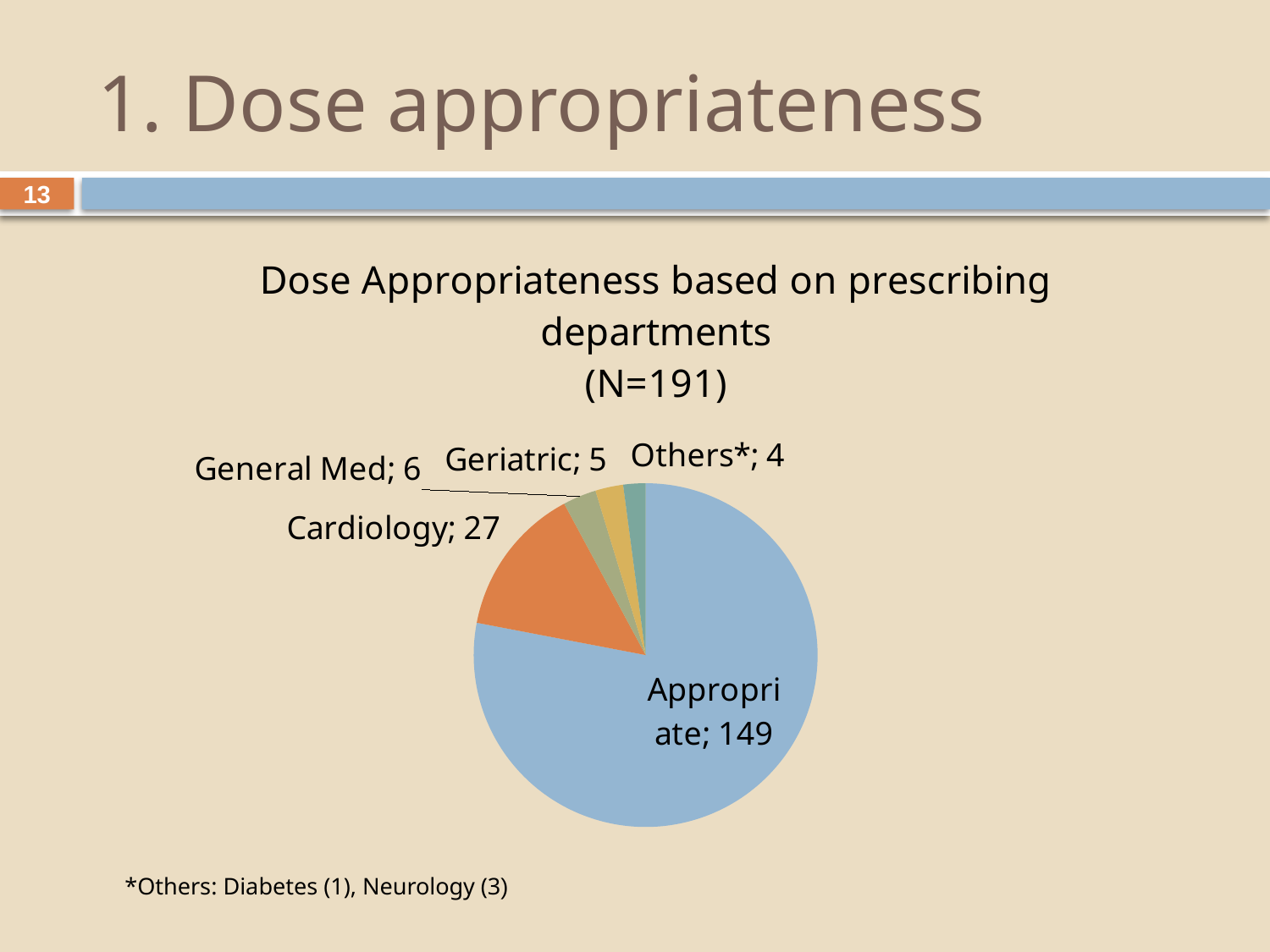
Which category has the largest slice? Appropriate What is the difference between the values for Appropriate and Cardiology? 122 Which category has the smallest slice? Others* What is the value for Cardiology? 27 What kind of chart is shown on the slide? pie chart How many slices does the pie chart have? 5 What is the title of the chart? Dose Appropriateness based on prescribing departments (N=191) Which is larger, the value for Cardiology or the value for General Med? Cardiology What is the value for Others*? 4 What is the value for Appropriate? 149 What is the value for Geriatric? 5 What is the value for General Med? 6